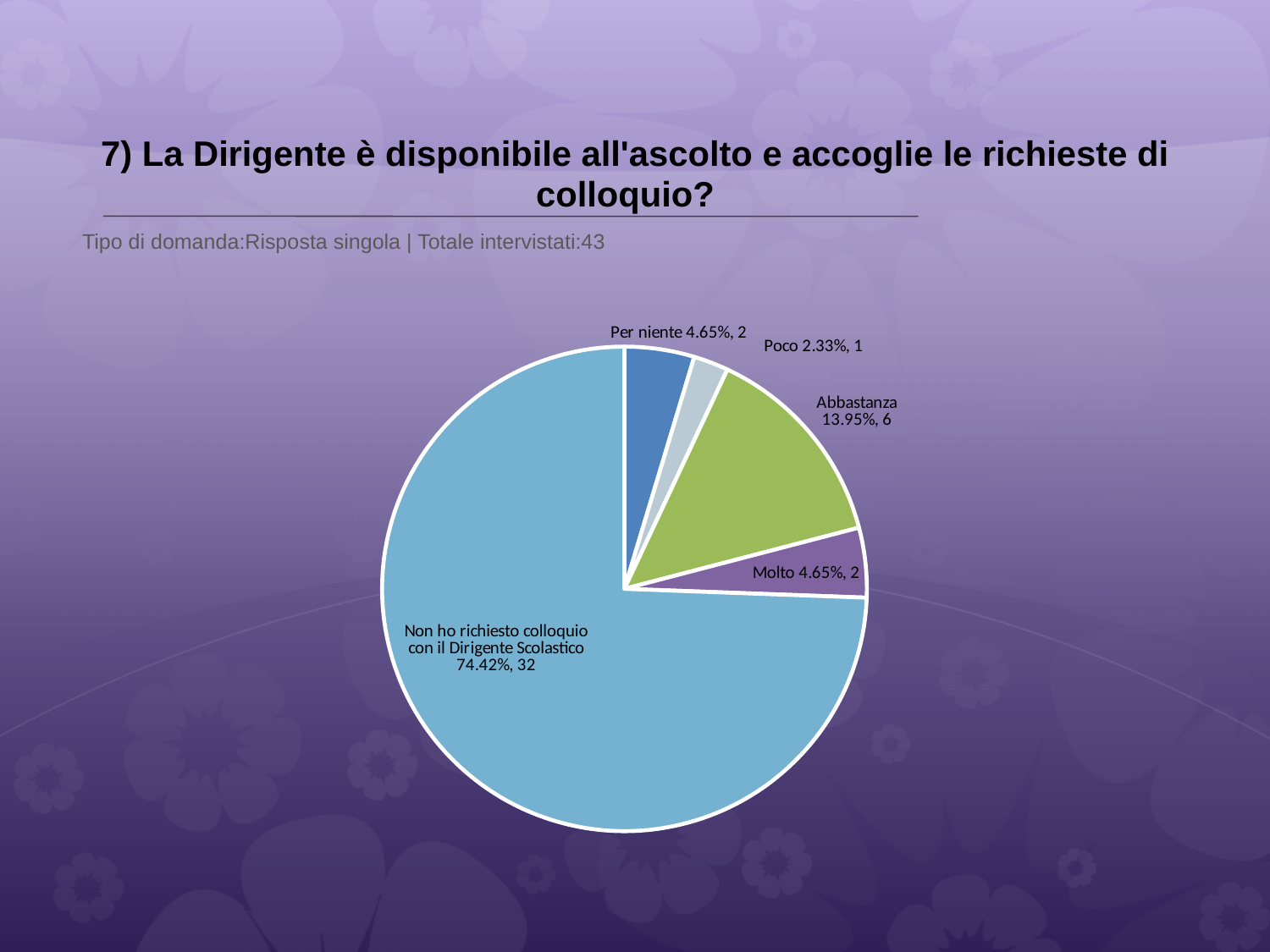
Which category has the largest slice of the pie? Non ho richiesto colloquio con il Dirigente Scolastico Which has a larger share, 'Abbastanza' or 'Per niente'? Abbastanza How many slices does the pie chart have? 5 How many respondents chose 'Molto'? 2 What percentage is shown for the 'Non ho richiesto colloquio con il Dirigente Scolastico' slice? 74.42% What percentage is shown for 'Poco'? 2.33% Which category has the smallest slice of the pie? Poco How many respondents chose 'Abbastanza'? 6 What is the share of the pie for 'Per niente'? 4.65% What is the total number of respondents stated on the slide? 43 What kind of chart is shown on the slide? pie chart What is the difference in respondent count between 'Abbastanza' and 'Molto'? 4